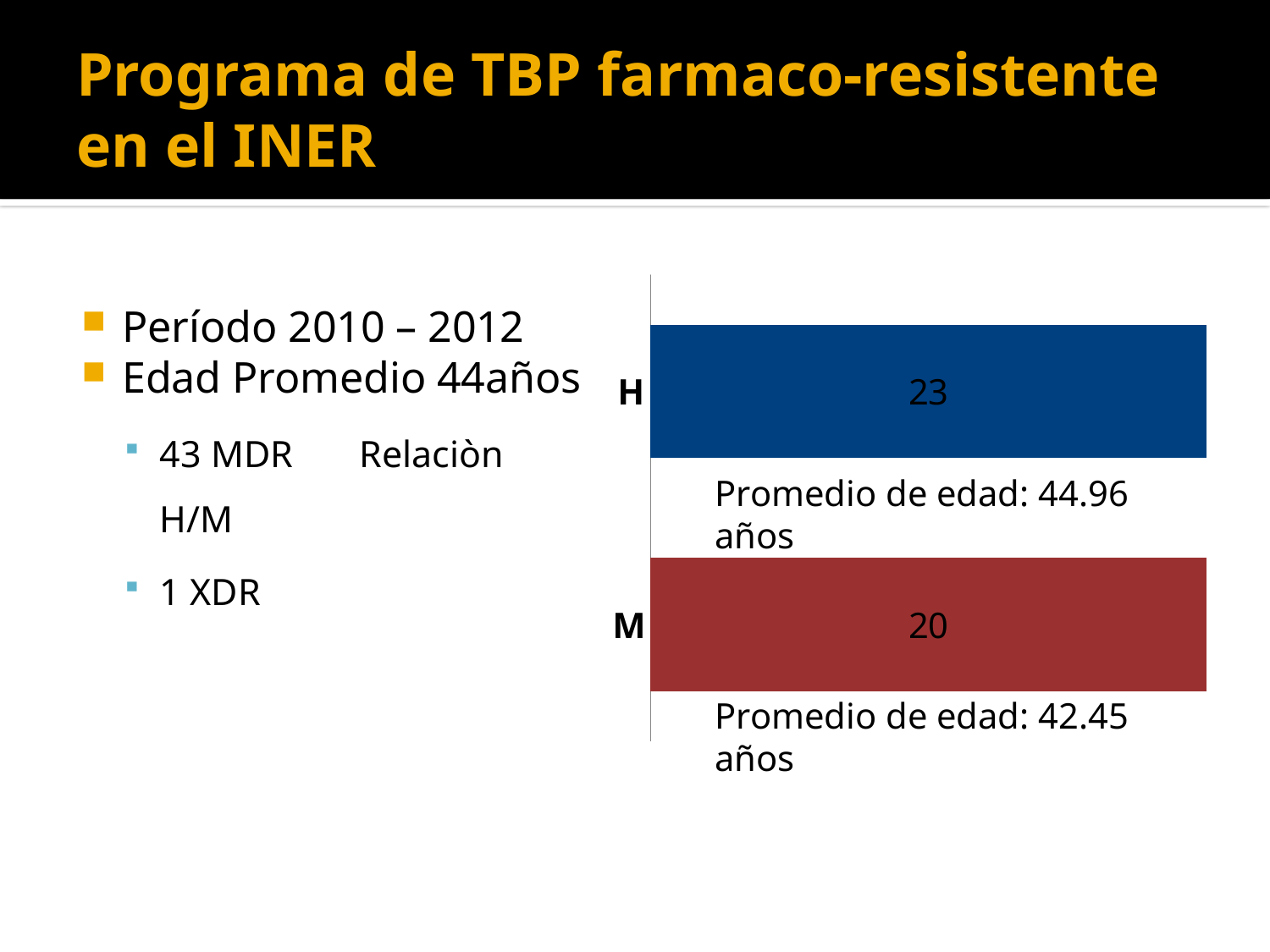
What kind of chart is shown on the slide? bar chart How many categories are shown in the bar chart? 2 What is the value for M in the bar chart? 20 What is the difference between the values for H and M in the bar chart? 3 Which category has the higher value in the bar chart, H or M? H Is the value for M larger or smaller than the value for H? smaller What is the total of the values for H and M in the bar chart? 43 What is the value for H in the bar chart? 23 What average age (promedio de edad) is printed below the H bar? 44.96 años What average age (promedio de edad) is printed below the M bar? 42.45 años Which category has the lowest value in the bar chart? M